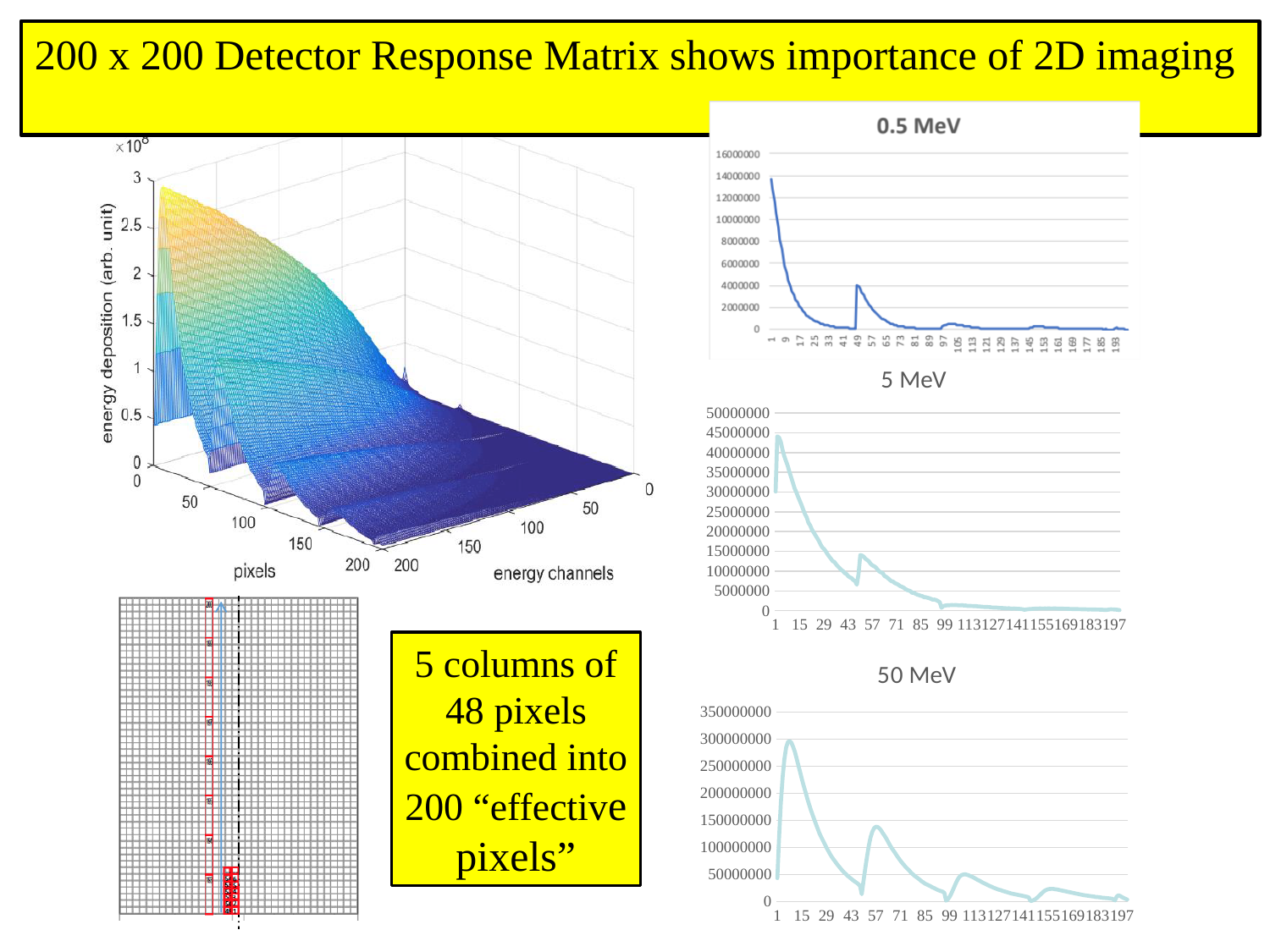
In the chart titled "50 MeV", is the highest value of the line greater or less than 250000000? greater In the chart titled "50 MeV", do the values overall rise or fall as the x axis increases? fall In the chart titled "50 MeV", is the value of the secondary peak near x = 57 greater or less than 100000000? greater In the chart titled "5 MeV", do the values overall rise or fall as the x axis increases? fall What are the titles of the three line charts on the right side of the slide? 0.5 MeV, 5 MeV, 50 MeV In the chart titled "5 MeV", is the value of the secondary peak near x = 50 greater or less than 20000000? less What kind of chart is the chart titled "0.5 MeV"? line chart What is the highest tick value shown on the y axis of the chart titled "50 MeV"? 350000000